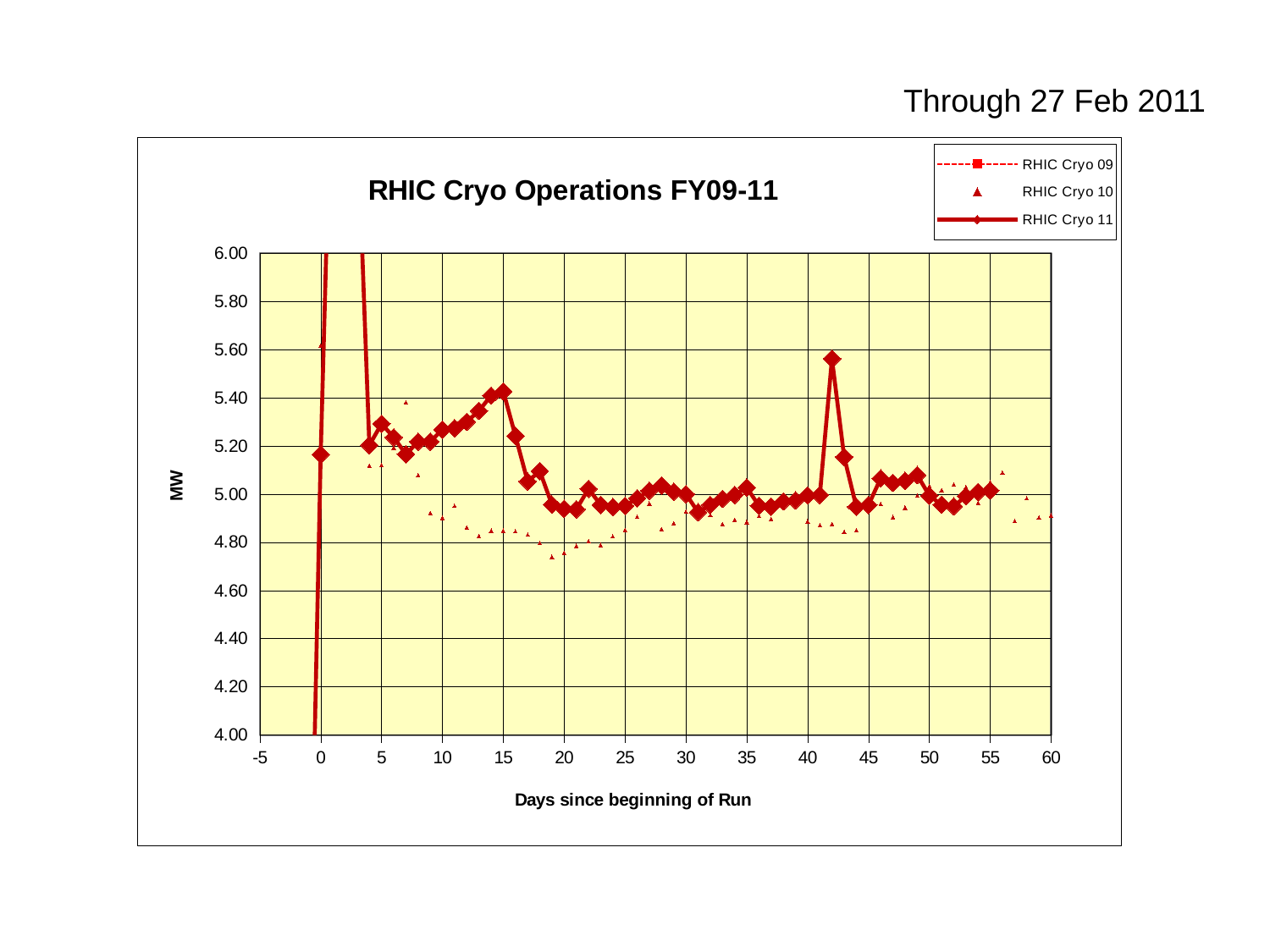
Does the RHIC Cryo 11 line rise or fall between day 15 and day 20? Fall What kind of chart is shown on the slide? Line chart What is the label of the y axis? MW Which is larger for RHIC Cryo 11: the value at day 42 or the value at day 43? Day 42 Is the RHIC Cryo 11 value at day 0 greater or less than 5.00? greater Is the RHIC Cryo 11 value at day 42 greater or less than 5.40? greater How many series does the legend list? 3 Does the RHIC Cryo 11 line rise or fall between day 7 and day 15? Rise Is the RHIC Cryo 11 value at day 15 greater or less than 5.20? greater What is the title of the chart? RHIC Cryo Operations FY09-11 Which is larger for RHIC Cryo 11: the value at day 15 or the value at day 20? Day 15